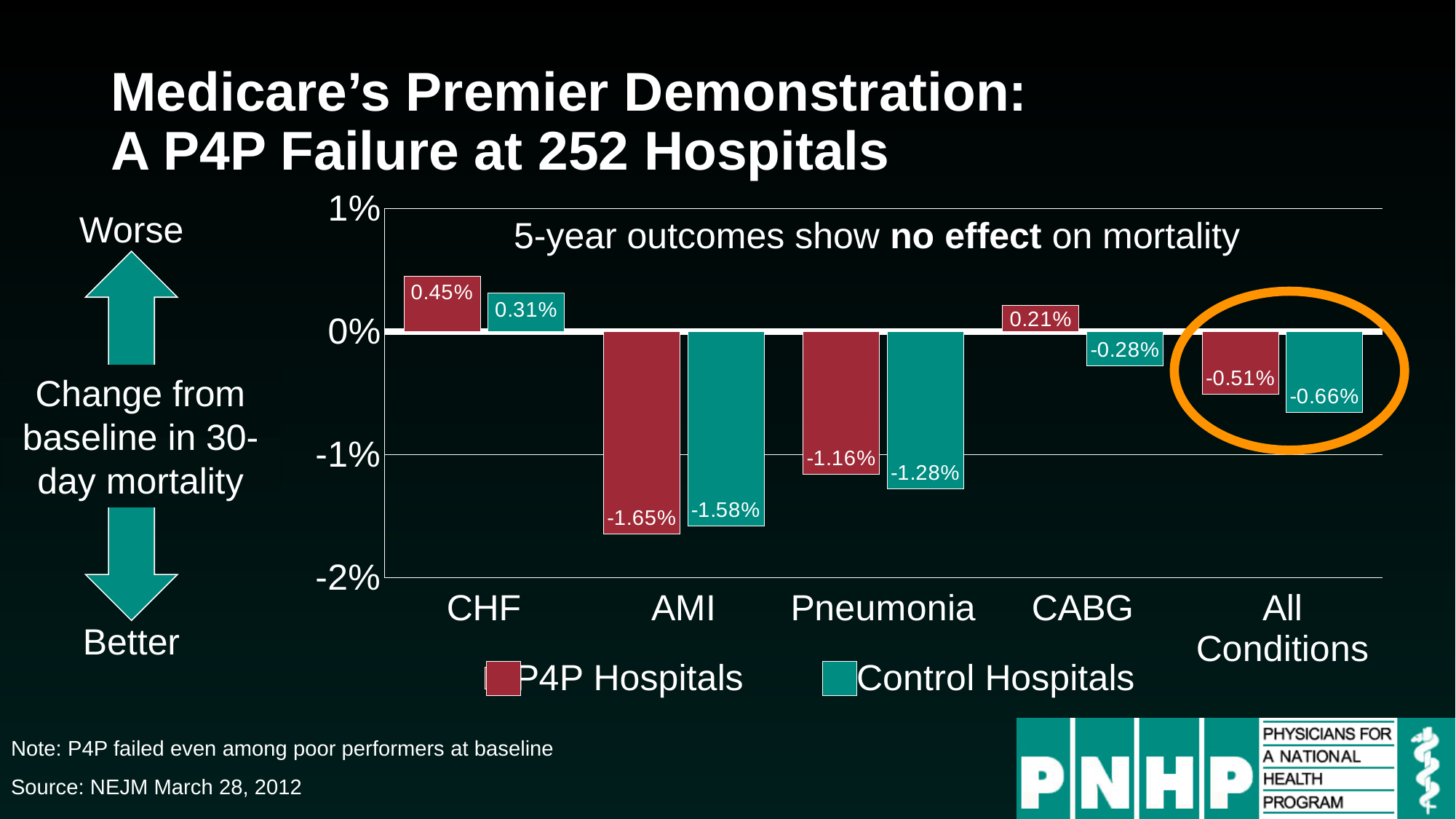
Which category is circled in orange on the chart? All Conditions What is the value for P4P Hospitals for CABG? 0.21% What is the difference between the P4P Hospitals and Control Hospitals values for AMI? 0.07% What is the value for Control Hospitals for Pneumonia? -1.28% Which is larger for CABG, the P4P Hospitals value or the Control Hospitals value? P4P Hospitals What is the value for P4P Hospitals for CHF? 0.45% What kind of chart is shown on the slide? Bar chart Which category has the highest value for Control Hospitals? CHF How many categories are shown on the x axis? 5 How many series does the legend list? 2 What is the value for Control Hospitals for All Conditions? -0.66% Which category has the lowest value for P4P Hospitals? AMI